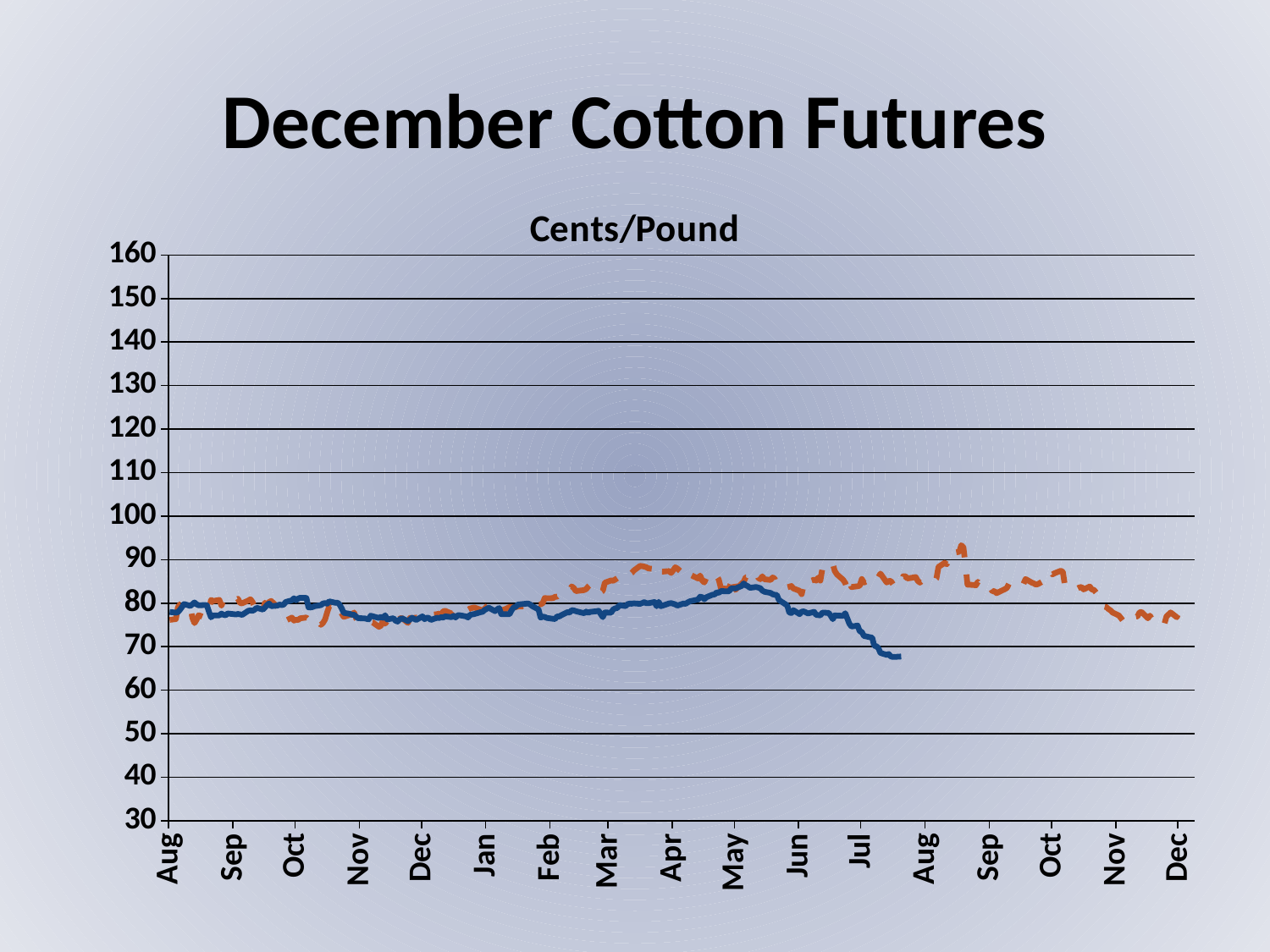
Which line reaches the highest point on the chart, the solid blue line or the orange dashed line? orange dashed line Is the lowest point of the solid blue line greater or less than 60? greater Does the orange dashed line rise or fall between Oct and Dec at the right end of the chart? fall Does the solid blue line rise or fall between May and Jul? fall Is the highest point of the orange dashed line (around Sep) greater or less than 80? greater How many lines are plotted on the chart? 2 What is the title shown above the chart? Cents/Pound How many month labels are shown along the x axis? 17 At Jul, which line is higher, the solid blue line or the orange dashed line? orange dashed line Is the final value of the solid blue line (around Jul) greater or less than 80? less What kind of chart is shown on the slide? line chart